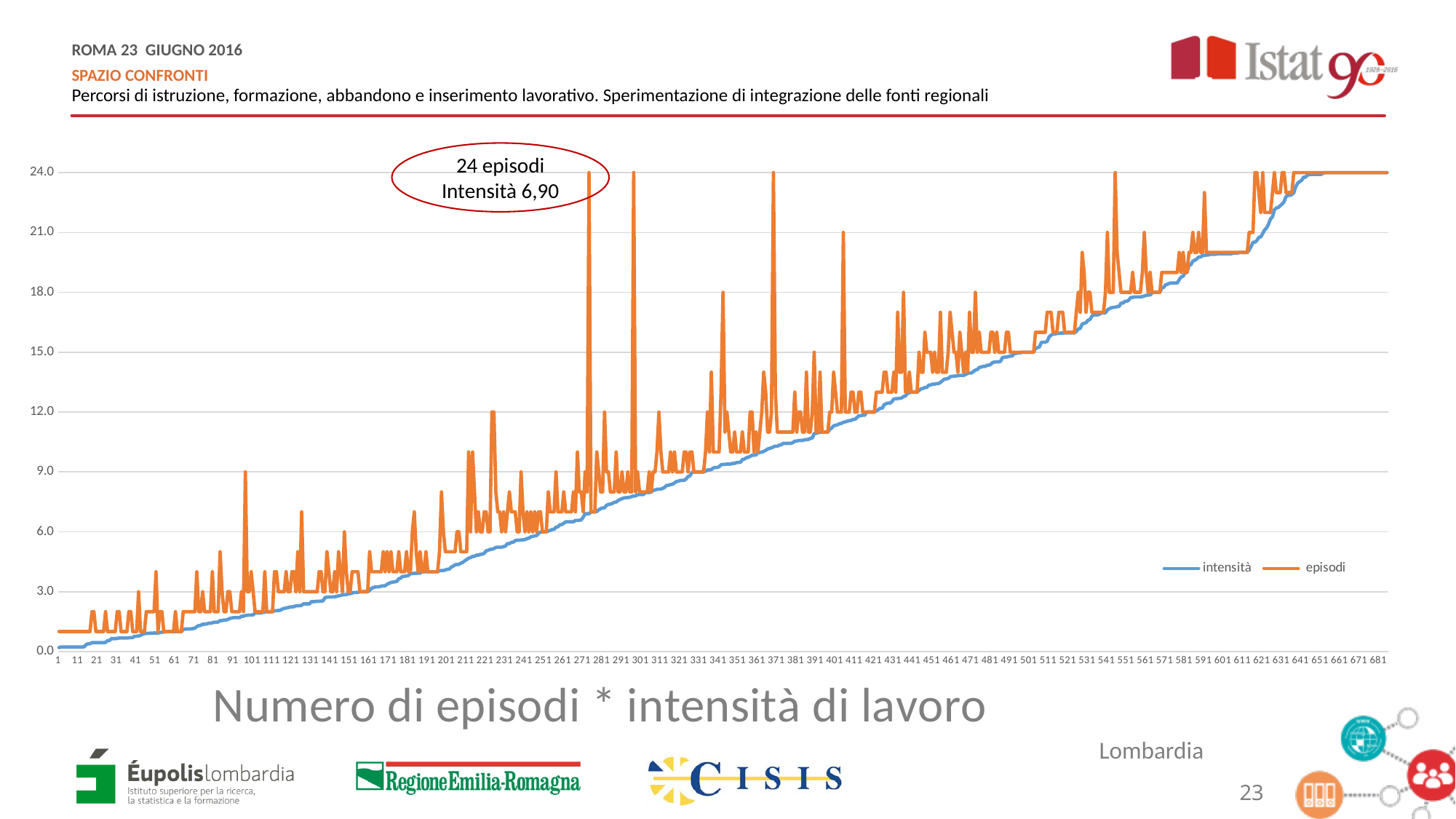
What are the two series named in the legend? intensità and episodi Is the value of intensità at x = 1 greater or less than 3.0? less Which series reaches the value 24.0 first along the x axis, intensità or episodi? episodi What kind of chart is shown on the slide? line chart What is the last label shown on the x axis? 681 How many series does the legend list? 2 What is the title printed below the chart? Numero di episodi * intensità di lavoro What intensità value is given in the circled annotation for the point with 24 episodi? 6,90 What is the highest value shown on the y axis? 24.0 Does the intensità series rise or fall along the x axis? rise Is the value of intensità at x = 681 greater or less than 21.0? greater Is the value of intensità at x = 401 greater or less than 9.0? greater